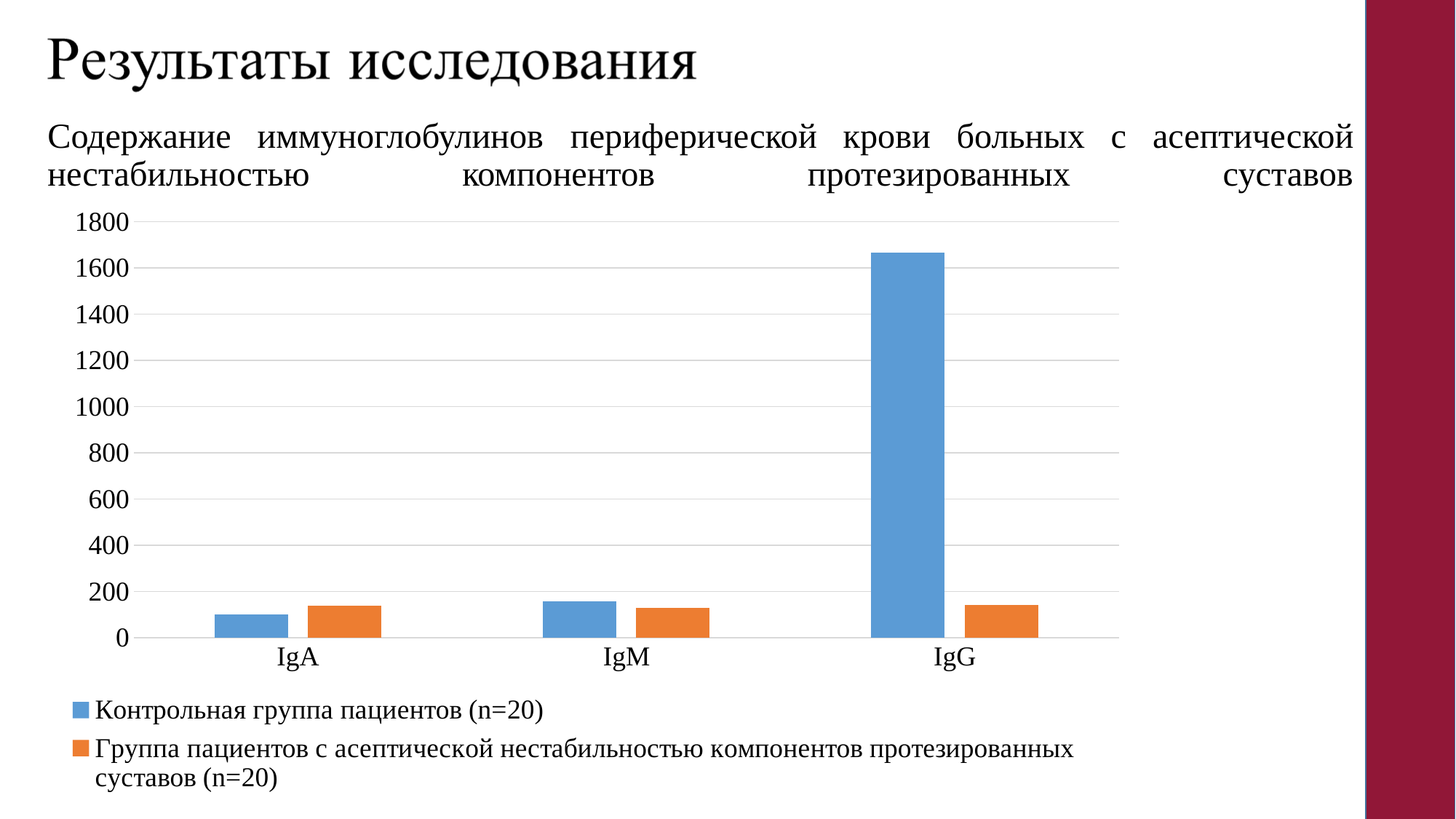
For the series "Контрольная группа пациентов (n=20)", which category has the highest value? IgG For the series "Контрольная группа пациентов (n=20)", which category has the lowest value? IgA For IgG, which series has the larger value: the control group or the group with aseptic instability? Контрольная группа пациентов (n=20) For IgA, which series has the larger value: the control group or the group with aseptic instability? Группа пациентов с асептической нестабильностью компонентов протезированных суставов (n=20) How many categories are shown on the x axis of the chart? 3 What kind of chart is shown on the slide? bar chart How many series does the chart legend list? 2 Is the value for IgA in the series "Контрольная группа пациентов (n=20)" greater or less than 200? less Is the value for IgG in the series "Группа пациентов с асептической нестабильностью компонентов протезированных суставов (n=20)" greater or less than 400? less Which colour represents the series "Контрольная группа пациентов (n=20)" in the chart? blue Is the value for IgG in the series "Контрольная группа пациентов (n=20)" greater or less than 1400? greater What are the three categories labelled on the x axis of the chart? IgA, IgM, IgG